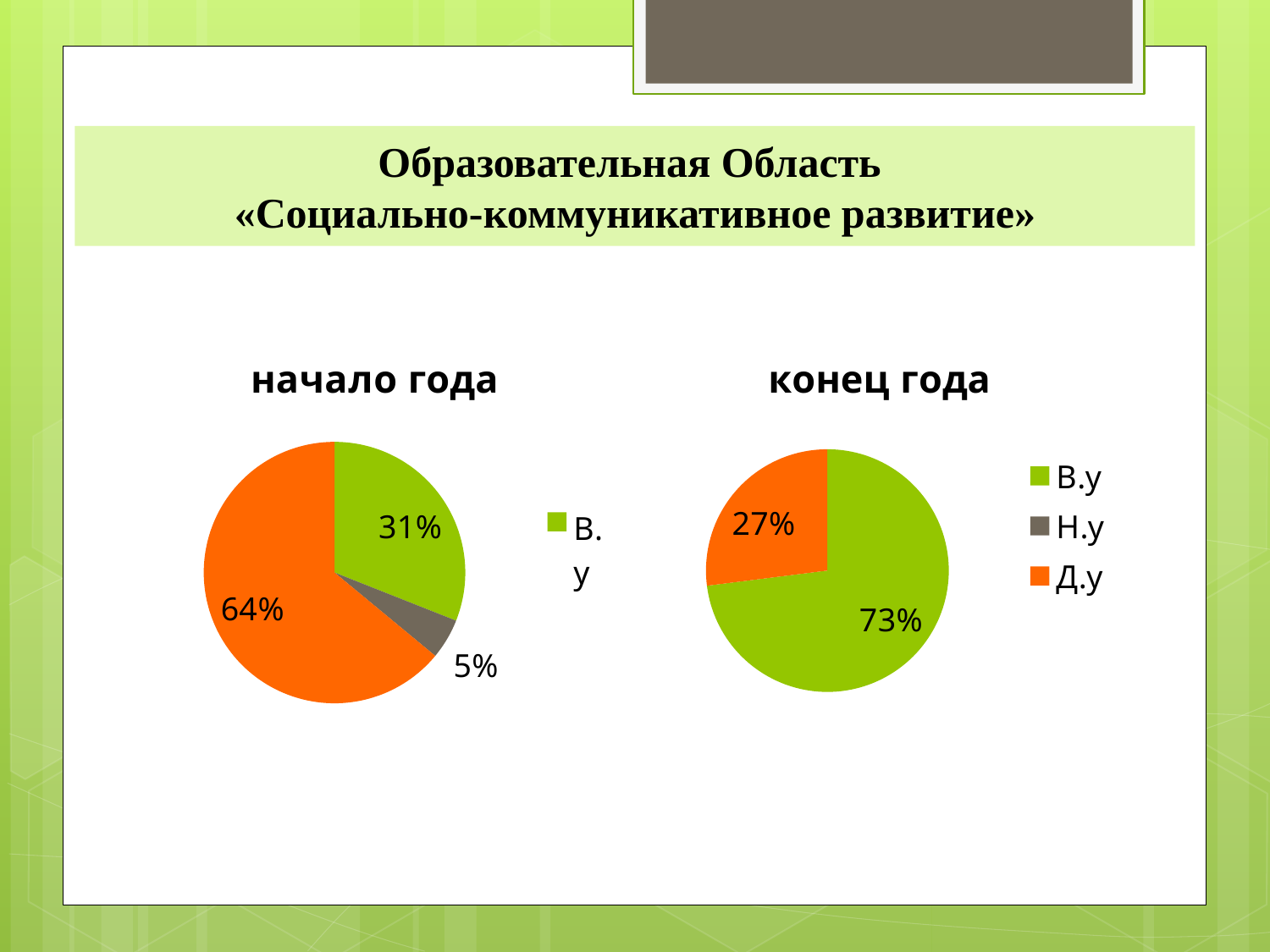
In the "конец года" chart, what is the difference between the В.у share and the Д.у share? 46% In the "конец года" chart, what share does Д.у have? 27% Which is larger: the green slice in the "начало года" chart or the В.у slice in the "конец года" chart? the В.у slice in the "конец года" chart In the "начало года" chart, what share does the green slice (В.у) have? 31% In the "конец года" chart, what share does В.у have? 73% In the "начало года" chart, what share does the orange slice have? 64% In the "начало года" chart, how many slices does the pie have? 3 What kind of chart is the "начало года" chart? pie chart In the "конец года" chart, how many entries does the legend list? 3 In the "начало года" chart, which slice is the smallest? the grey slice (5%) In the "начало года" chart, what share does the grey slice have? 5% In the "начало года" chart, which slice is the largest? the orange slice (64%)